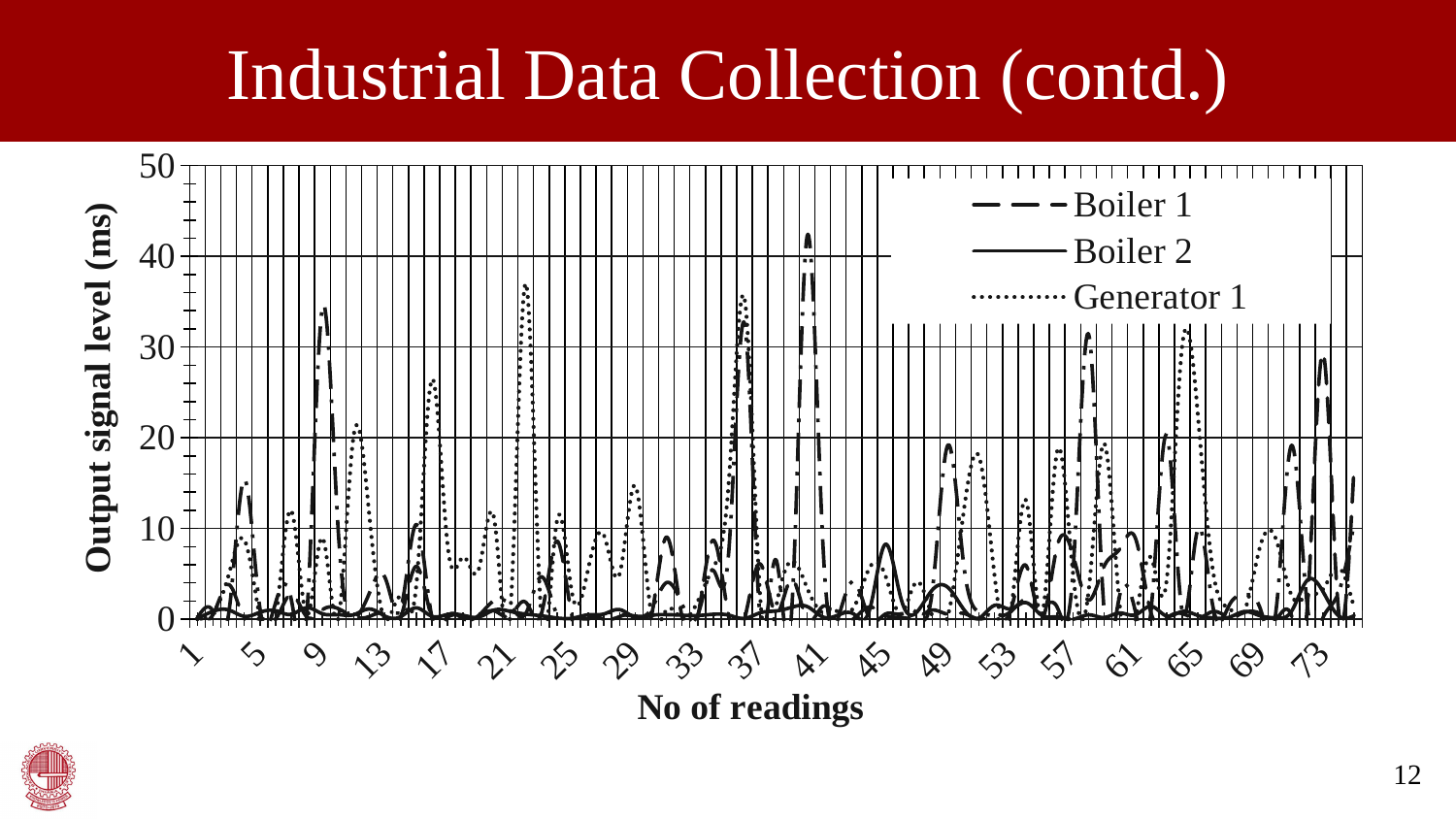
What are the three series named in the legend? Boiler 1, Boiler 2, Generator 1 How many series does the legend list? 3 What kind of chart is shown on the slide? Line chart Is the highest peak of Generator 1 (near reading 22) greater or less than 30? greater What is the first reading number labelled on the horizontal axis? 1 Which series has a higher peak, Boiler 1 or Boiler 2? Boiler 1 What is the title of the vertical axis? Output signal level (ms) Which series stays lowest across the readings? Boiler 2 What is the highest value shown on the vertical axis? 50 Is the highest value of Boiler 2 greater or less than 20? less